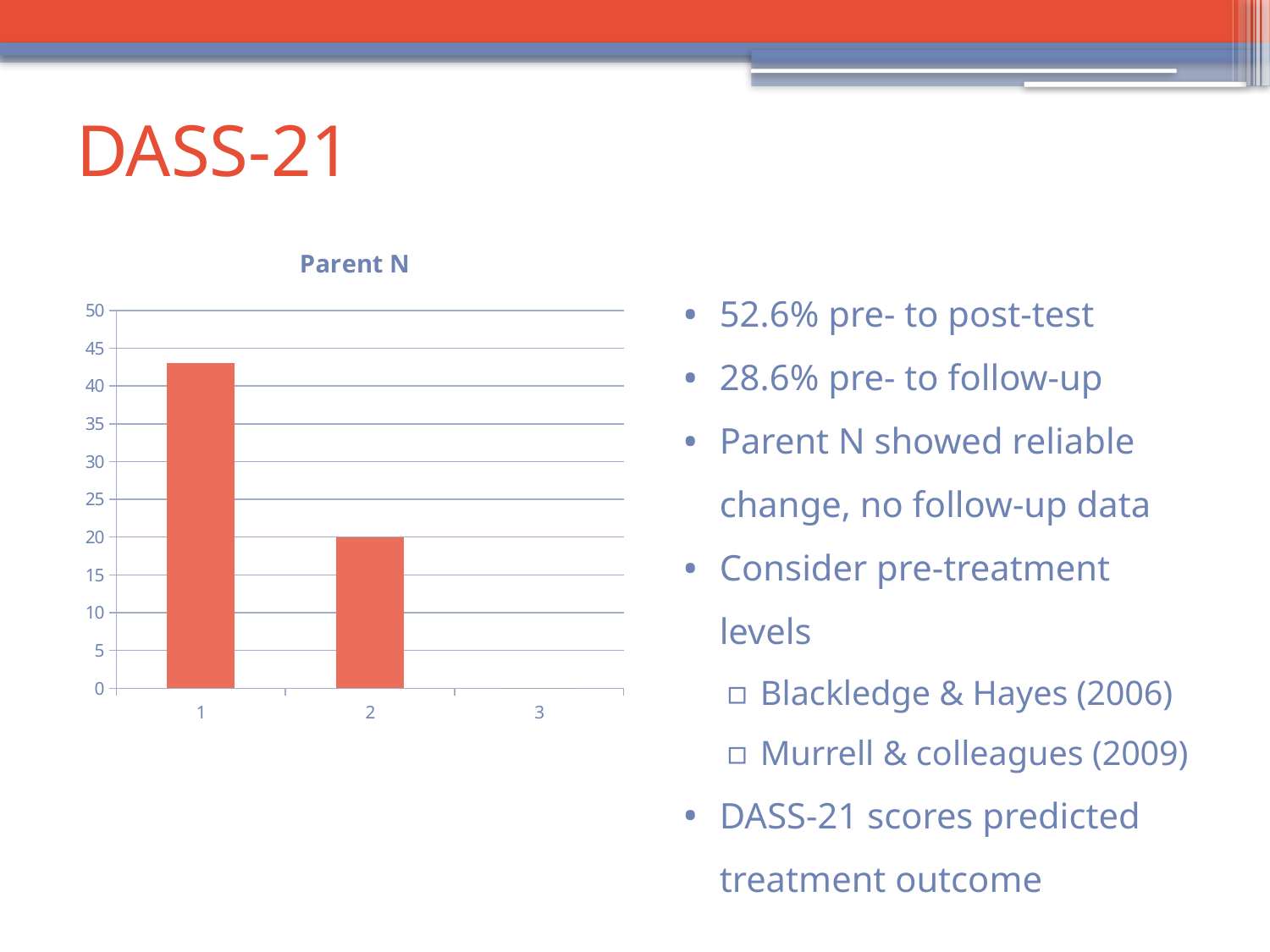
How many categories are shown on the x axis of the chart? 3 What is the title of the chart? Parent N What is the maximum value shown on the y axis of the chart? 50 Do the bar values rise or fall from category 1 to category 2? fall What kind of chart is shown on the slide? bar chart Which is larger, the value for category 1 or the value for category 2? category 1 Is the value for category 2 greater or less than 25? less Is the value for category 1 greater or less than 45? less Which category on the x axis has no bar plotted? 3 Is the value for category 1 greater or less than 40? greater Which category has the highest bar in the Parent N chart? 1 What is the value for category 2 in the Parent N chart? 20